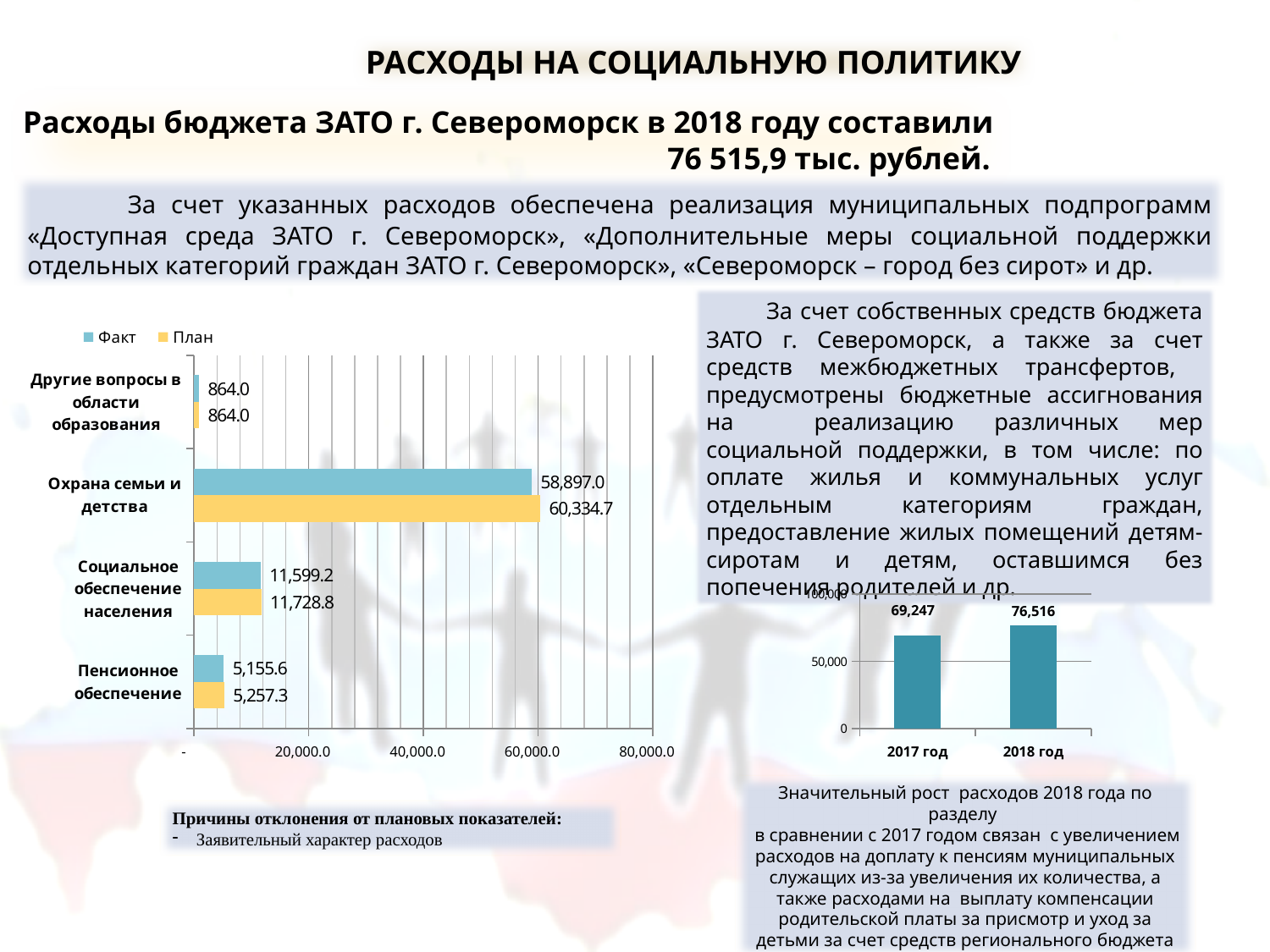
In the right chart, what is the difference between the values for 2018 год and 2017 год? 7,269 In the left chart, which category has the lowest План value? Другие вопросы в области образования In the right chart, what is the value for 2018 год? 76,516 In the left chart, which is larger for Пенсионное обеспечение: Факт or План? План In the left chart, what is the План value for Пенсионное обеспечение? 5,257.3 In the left chart, which category has the highest Факт value? Охрана семьи и детства In the left chart, what is the План value for Социальное обеспечение населения? 11,728.8 In the left chart, how many series does the legend list? 2 What type of chart is the chart on the right showing 2017 год and 2018 год? Bar chart In the left chart, how many categories are shown? 4 In the left chart, what is the difference between the План and Факт values for Охрана семьи и детства? 1,437.7 In the left chart, what is the Факт value for Охрана семьи и детства? 58,897.0